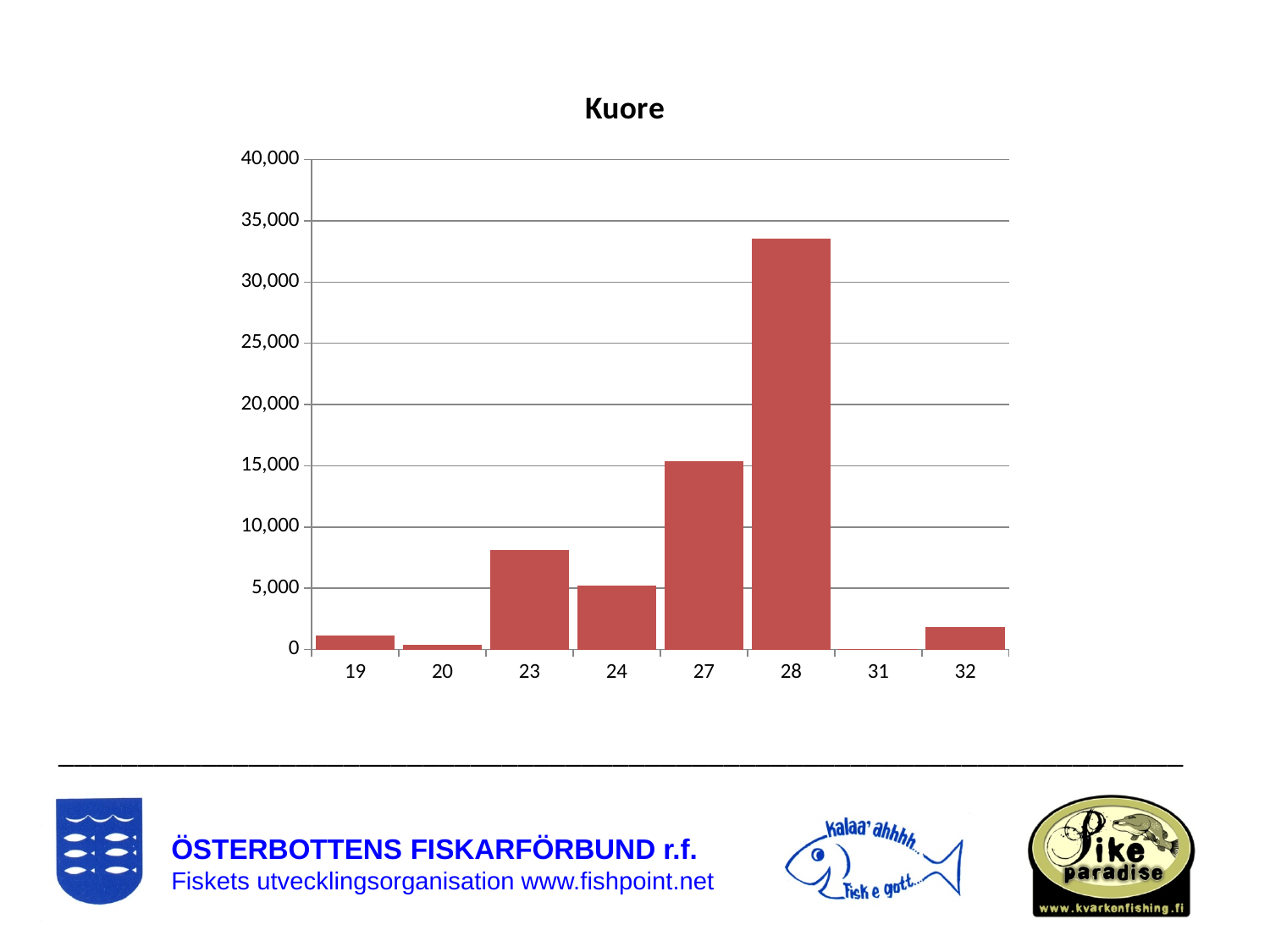
What kind of chart is shown on the slide? bar chart What is the title of the chart? Kuore Is the value for 32 greater or less than 5,000? less Is the value for 28 greater or less than 30,000? greater How many categories are shown on the x axis of the chart? 8 Which has a larger value, 19 or 32? 32 Is the value for 23 greater or less than 10,000? less Which category has the highest value in the chart? 28 Which category has the lowest value in the chart? 31 Which has a larger value, 23 or 24? 23